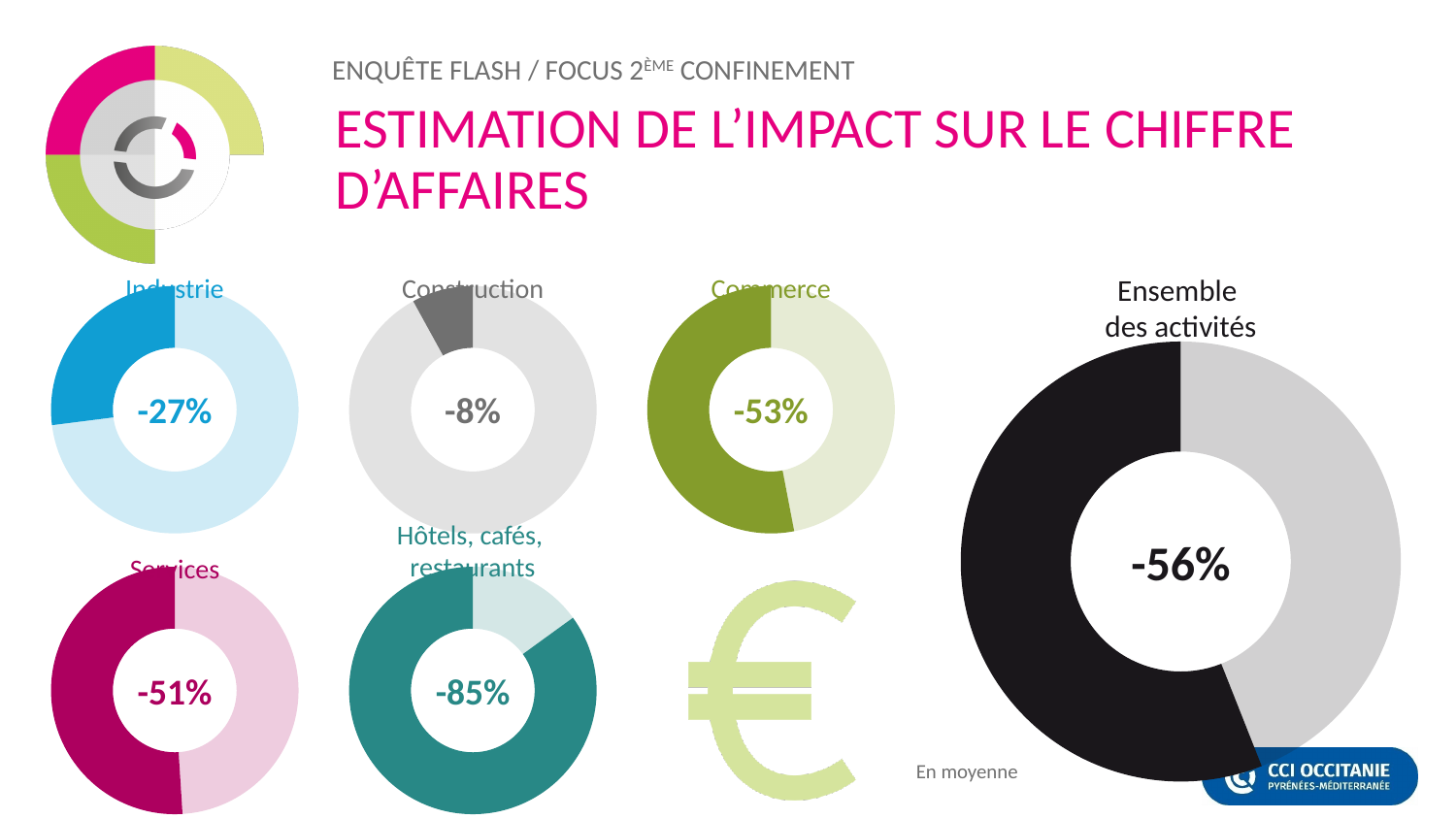
How many donut charts are shown on the slide (excluding the logo)? 6 What value is shown in the centre of the Industrie donut chart? -27% What is the difference in percentage points between the Hôtels, cafés, restaurants value and the Construction value? 77 percentage points What kind of chart is used to show the impact for each sector? Donut chart What value is shown in the centre of the Commerce donut chart? -53% Which sector's donut chart shows the smallest decline in turnover? Construction What value is shown in the centre of the Hôtels, cafés, restaurants donut chart? -85% Which sector's donut chart shows the largest decline in turnover? Hôtels, cafés, restaurants What value is shown in the centre of the Services donut chart? -51% What value is shown in the centre of the Construction donut chart? -8% Which shows a larger decline: the Industrie chart or the Services chart? Services What value is shown in the centre of the Ensemble des activités donut chart? -56%